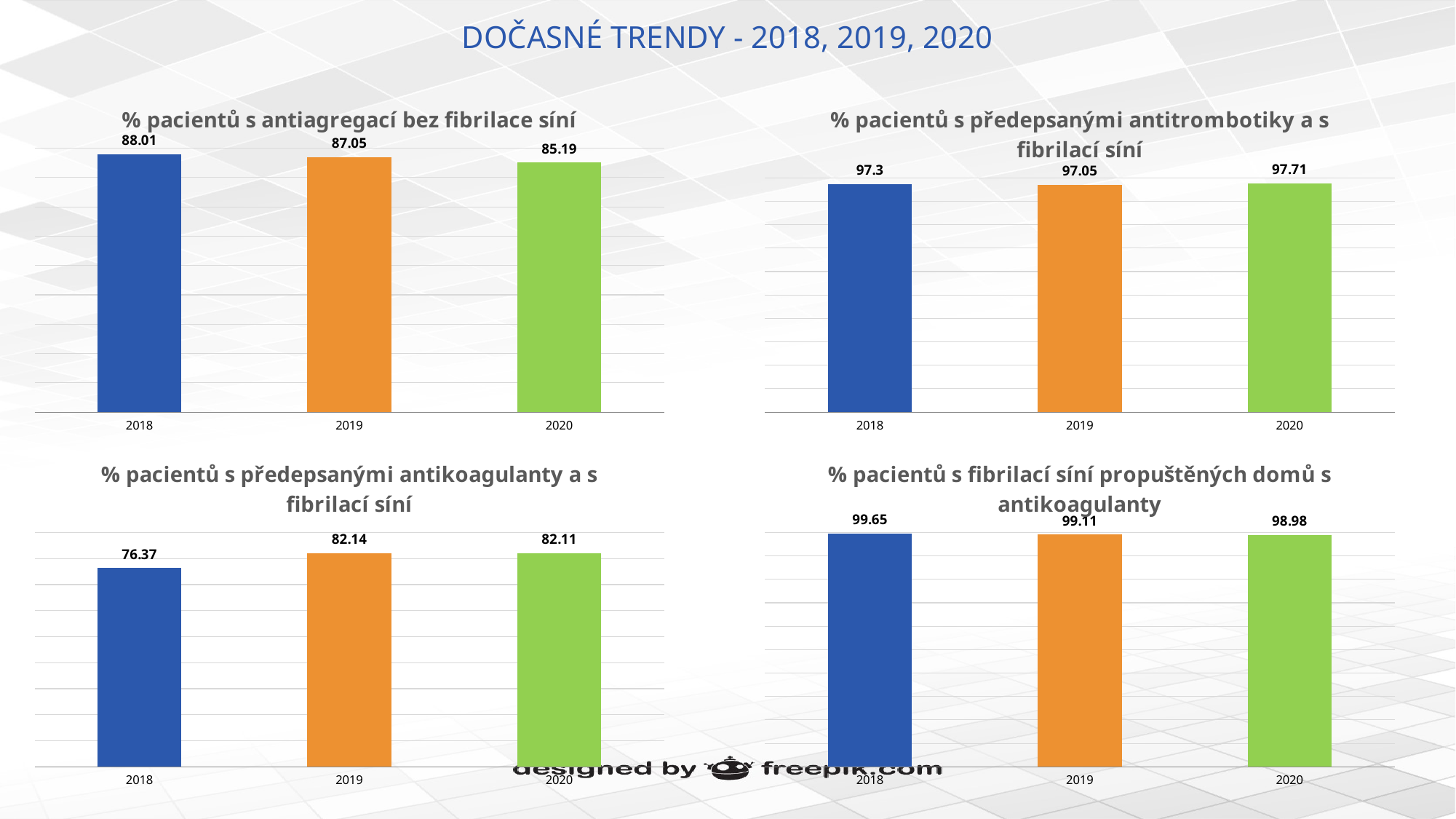
How many bars are in the chart '% pacientů s fibrilací síní propuštěných domů s antikoagulanty'? 3 In the chart '% pacientů s předepsanými antitrombotiky a s fibrilací síní', what is the value for 2020? 97.71 In the chart '% pacientů s fibrilací síní propuštěných domů s antikoagulanty', which is larger, the value for 2018 or for 2020? 2018 In the chart '% pacientů s antiagregací bez fibrilace síní', what is the value for 2018? 88.01 In the chart '% pacientů s předepsanými antikoagulanty a s fibrilací síní', what is the value for 2018? 76.37 In the chart '% pacientů s fibrilací síní propuštěných domů s antikoagulanty', what is the value for 2019? 99.11 In the chart '% pacientů s předepsanými antikoagulanty a s fibrilací síní', what is the difference between the 2019 and 2018 values? 5.77 In the chart '% pacientů s předepsanými antitrombotiky a s fibrilací síní', what is the difference between the 2020 and 2019 values? 0.66 In the chart '% pacientů s antiagregací bez fibrilace síní', which year has the lowest value? 2020 What type of chart is '% pacientů s antiagregací bez fibrilace síní'? bar chart In the chart '% pacientů s antiagregací bez fibrilace síní', do the values rise or fall from 2018 to 2020? fall In the chart '% pacientů s předepsanými antikoagulanty a s fibrilací síní', which year has the highest value? 2019